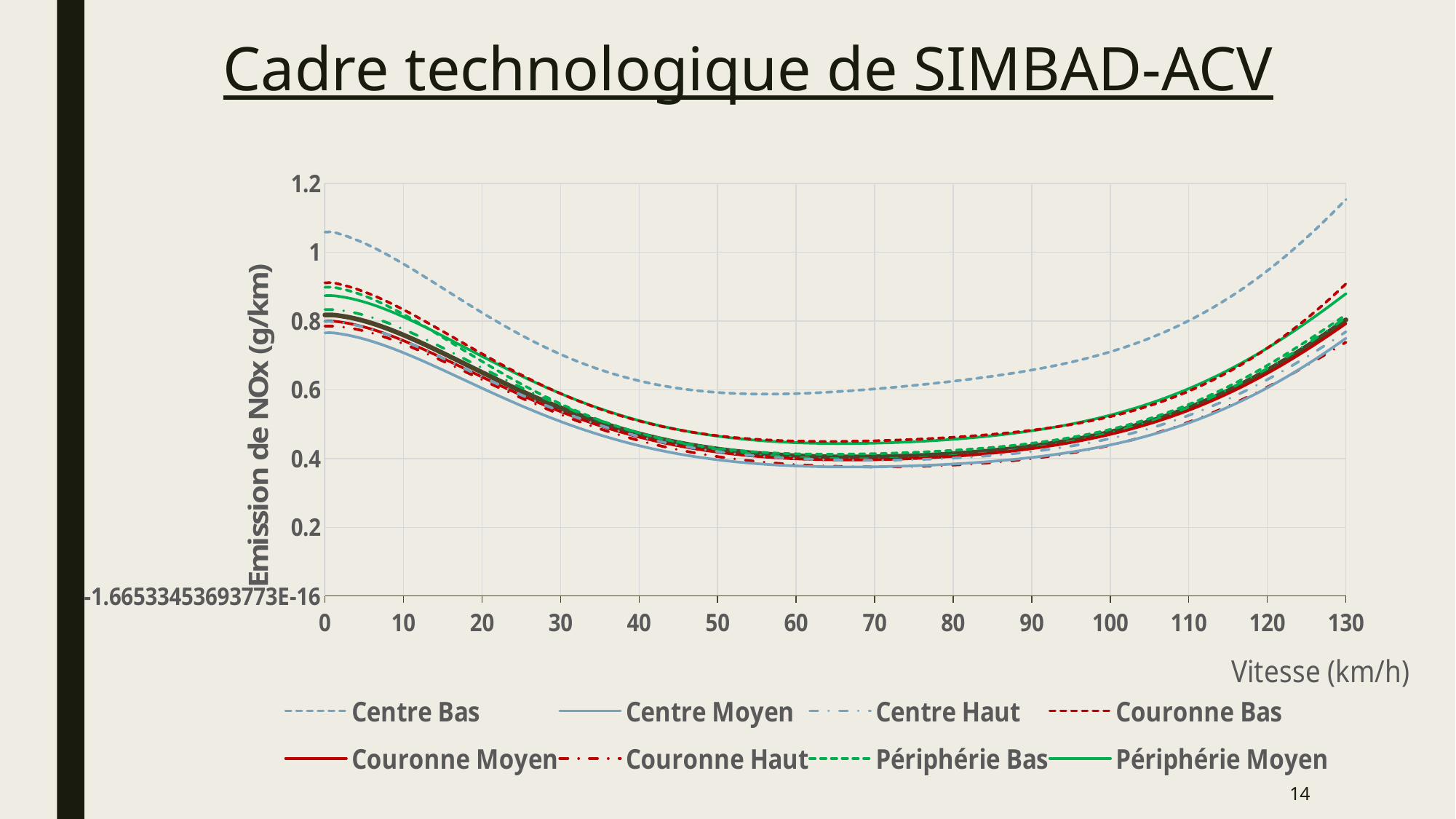
Which series has the highest NOx emission at 60 km/h? Centre Bas What is the label of the y axis? Emission de NOx (g/km) Is the value for Centre Bas at 60 km/h greater or less than 0.4? greater What kind of chart is shown on the slide? line chart How many series does the legend list? 8 Is the value for Périphérie Moyen at 0 km/h greater or less than 0.8? greater Which series has the highest NOx emission at 130 km/h? Centre Bas Is the value for Couronne Bas at 130 km/h greater or less than 0.8? greater At 60 km/h, which is larger: Centre Bas or Centre Moyen? Centre Bas Do the NOx emission values rise or fall as speed increases from 0 to 60 km/h? fall Do the NOx emission values rise or fall as speed increases from 80 to 130 km/h? rise